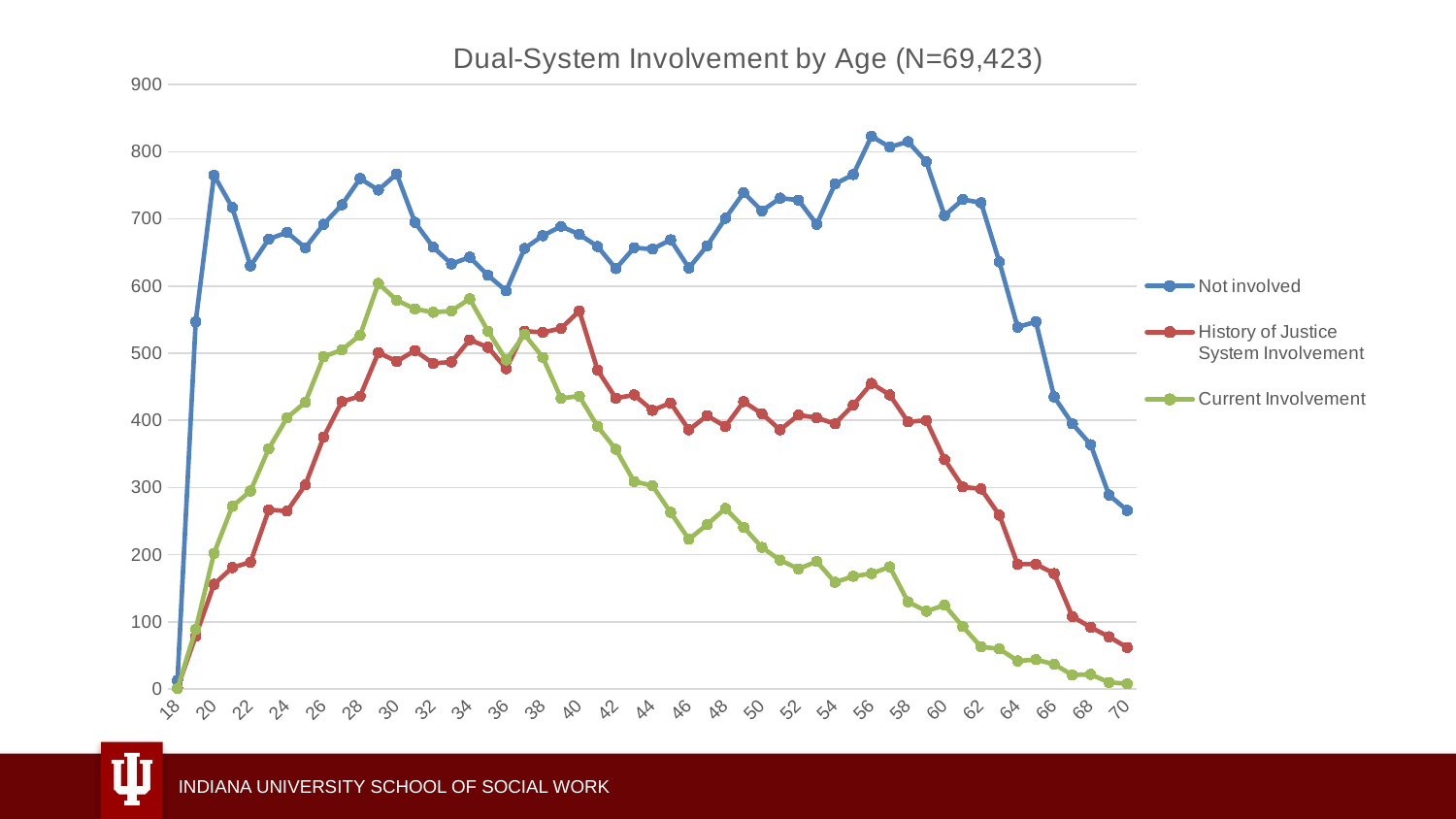
What kind of chart is shown on the slide? Line chart How many series does the legend list? 3 At age 50, which is larger: History of Justice System Involvement or Current Involvement? History of Justice System Involvement Is the value for History of Justice System Involvement at age 40 greater or less than 500? greater What is the title of the chart? Dual-System Involvement by Age (N=69,423) Which series has the lowest value at age 60? Current Involvement At age 40, which is larger: Not involved or History of Justice System Involvement? Not involved Is the value for Current Involvement at age 70 greater or less than 100? less Which colour is used for the Current Involvement series? Green Does the Not involved series rise or fall from age 62 to age 70? Fall Is the value for Not involved at age 56 greater or less than 800? greater